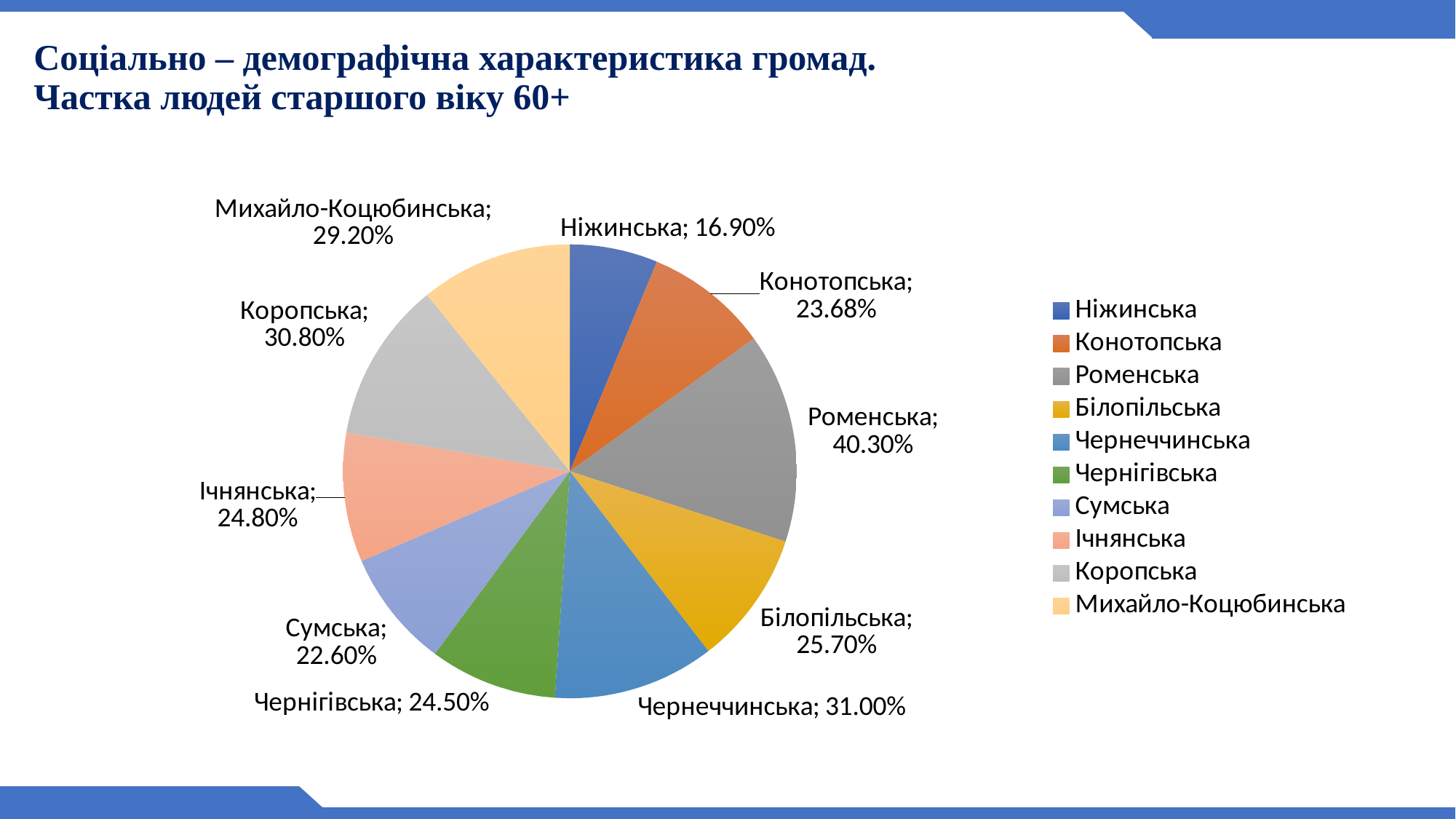
Which category has the lowest value? Ніжинська Which category has the highest value? Роменська What kind of chart is shown on the slide? Pie chart Which category is shown in green in the legend? Чернігівська What value is shown for Чернеччинська? 31.00% What is the difference between the values for Роменська and Ніжинська? 23.40% What value is shown for Роменська? 40.30% What is the difference between the values for Коропська and Сумська? 8.20% Which is larger, the value for Коропська or the value for Михайло-Коцюбинська? Коропська What value is shown for Конотопська? 23.68% How many categories are shown in the pie chart? 10 What value is shown for Ніжинська? 16.90%